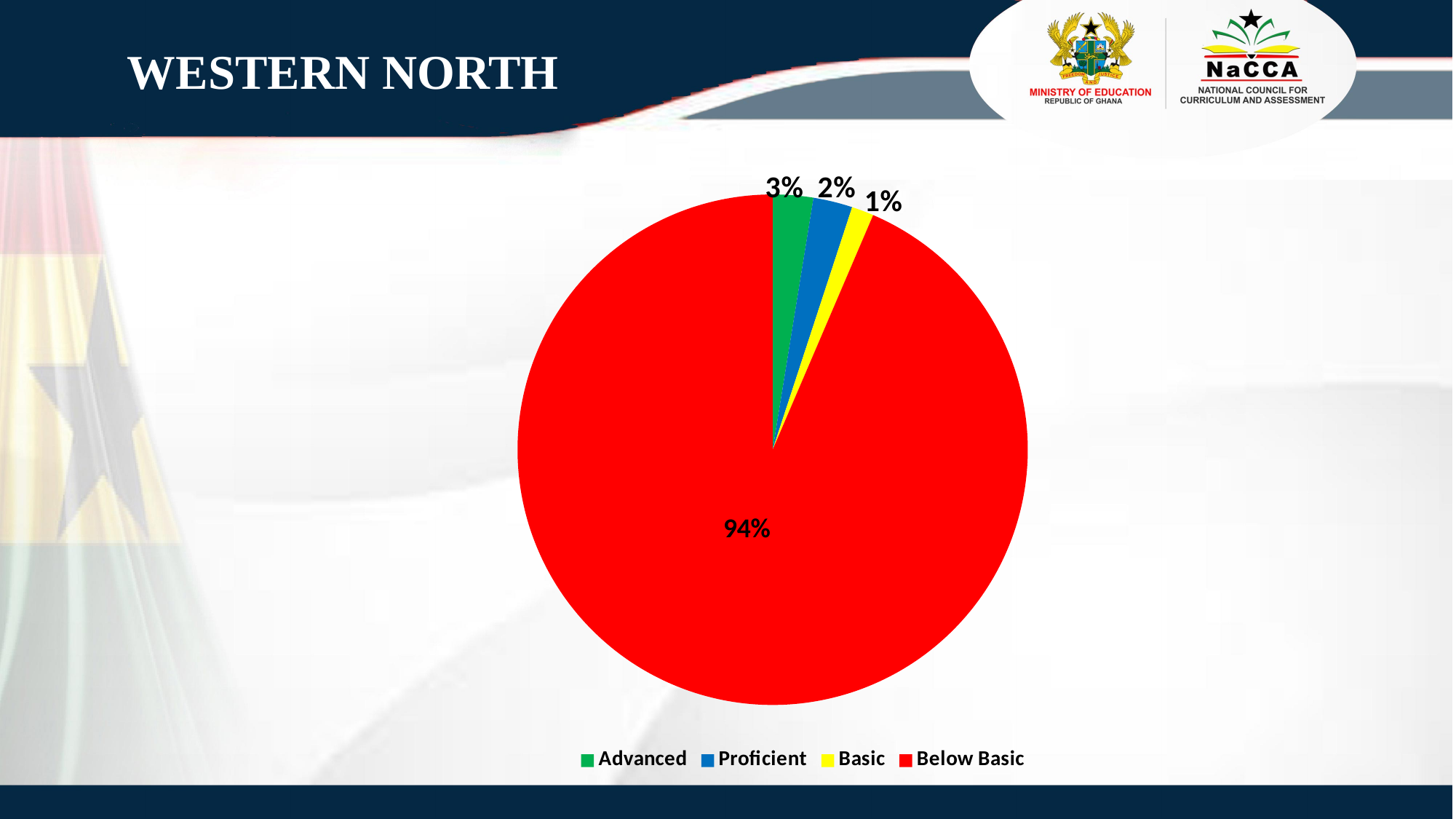
What colour is the Below Basic slice? red What percentage of the pie is Below Basic? 94% What percentage of the pie is Basic? 1% What percentage of the pie is Advanced? 3% Which category has the largest slice of the pie? Below Basic What is the difference in percentage points between Below Basic and Advanced? 91 Which is larger, the Advanced slice or the Proficient slice? Advanced What percentage of the pie is Proficient? 2% How many categories does the pie chart show? 4 Which category has the smallest slice of the pie? Basic What kind of chart is shown on the slide? pie chart Which category is shown in yellow in the legend? Basic